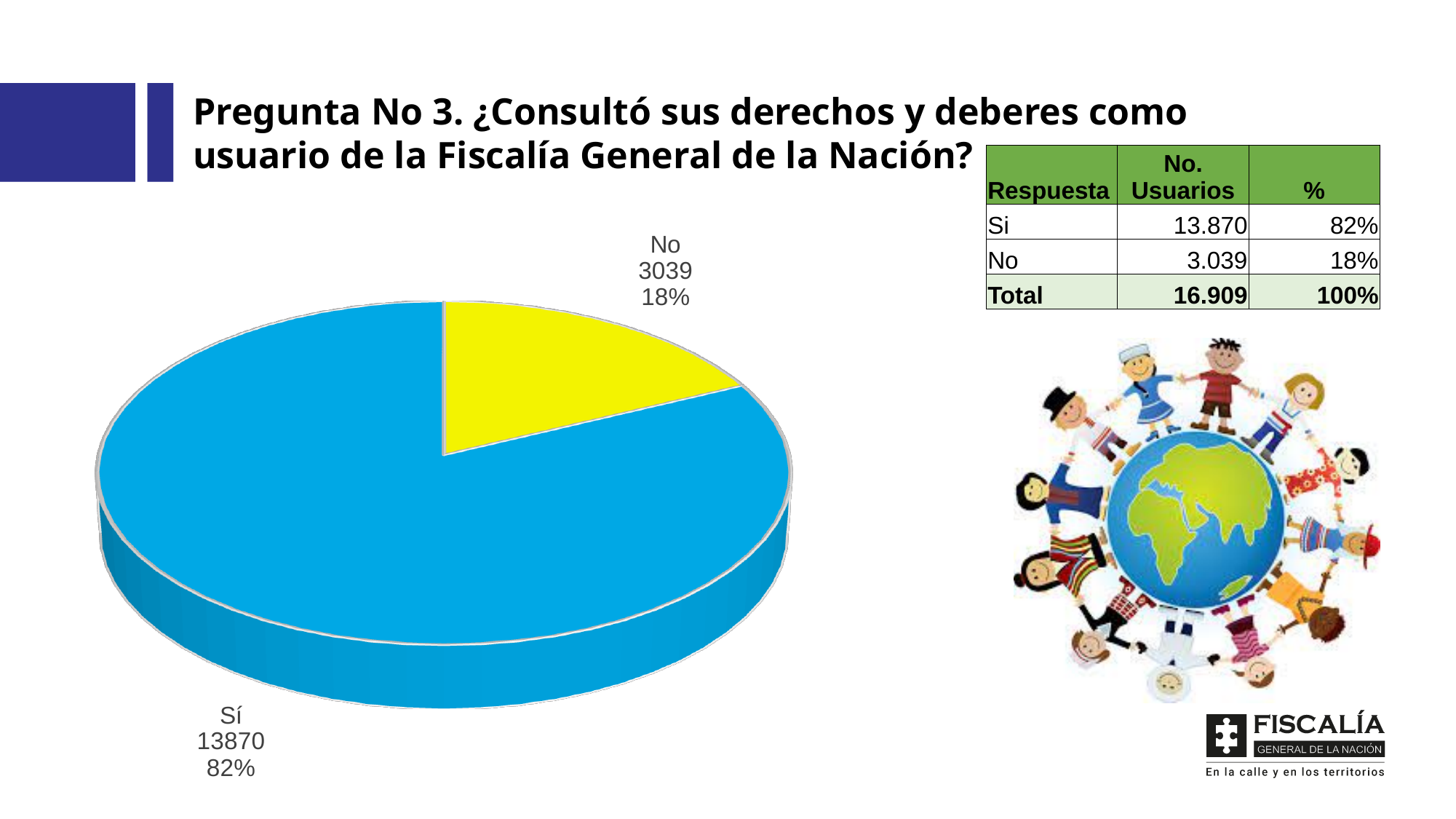
Which slice of the pie chart is the smallest? No What percentage share of the pie does the "No" slice represent? 18% What colour is the "No" slice in the pie chart? yellow How many slices does the pie chart have? 2 What is the value shown for the "No" slice in the pie chart? 3039 What is the difference between the "Sí" and "No" values in the pie chart? 10831 Which is larger in the pie chart, the "Sí" value or the "No" value? Sí What is the value shown for the "Sí" slice in the pie chart? 13870 What colour is the "Sí" slice in the pie chart? blue What percentage share of the pie does the "Sí" slice represent? 82% What kind of chart is shown on the slide? pie chart Which slice of the pie chart is the largest? Sí